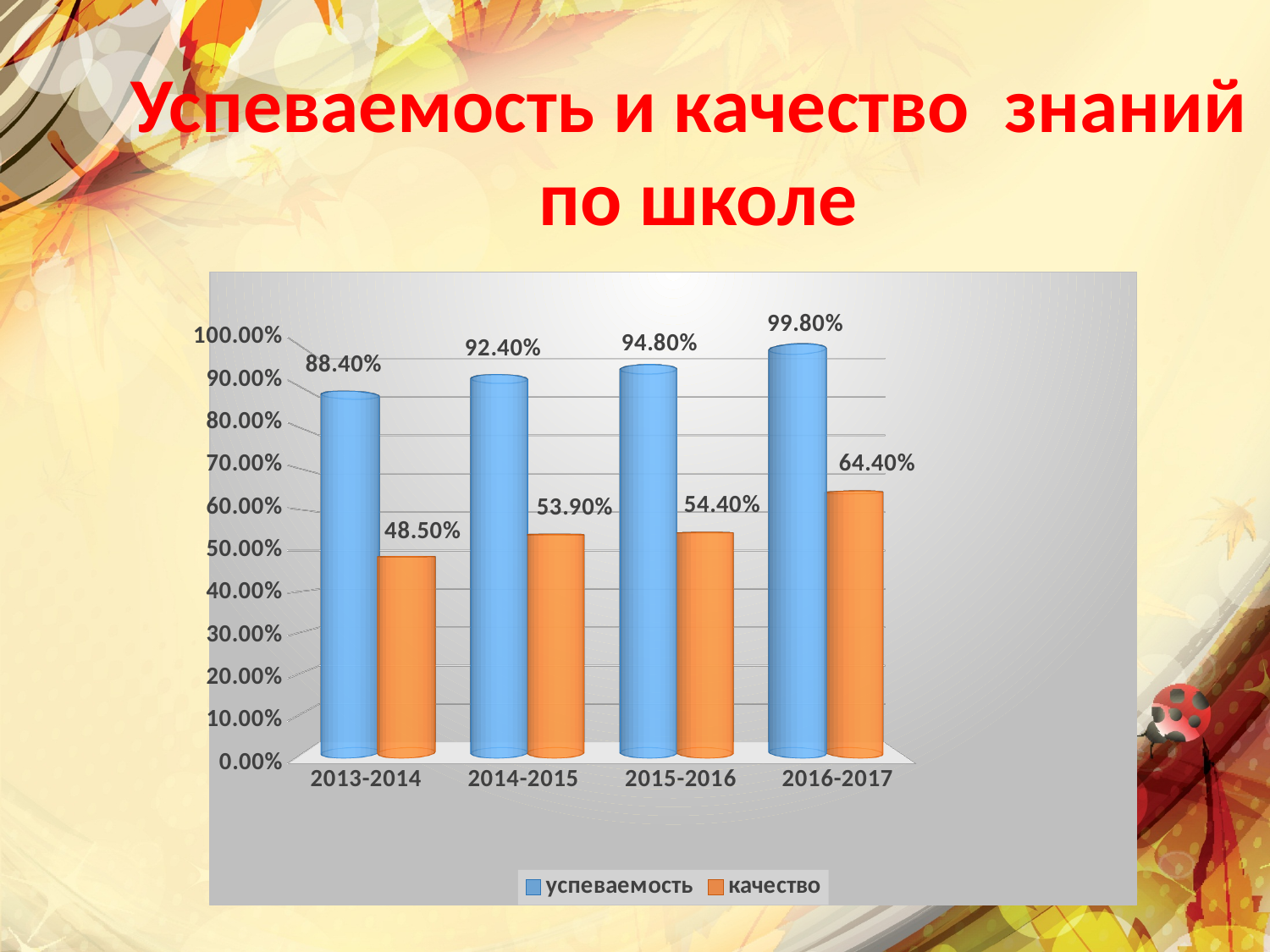
What is the value of успеваемость for 2013-2014? 88.40% In which year is качество lowest? 2013-2014 How many series does the legend list? 2 In which year is успеваемость highest? 2016-2017 Which is larger: качество in 2014-2015 or качество in 2015-2016? качество in 2015-2016 What is the value of качество for 2016-2017? 64.40% What kind of chart is shown on the slide? bar chart Which colour represents the series качество in the legend? orange Does успеваемость rise or fall from 2013-2014 to 2016-2017? rise How many year categories are shown on the x axis? 4 What is the value of качество for 2014-2015? 53.90% What is the difference between успеваемость and качество in 2015-2016? 40.40%